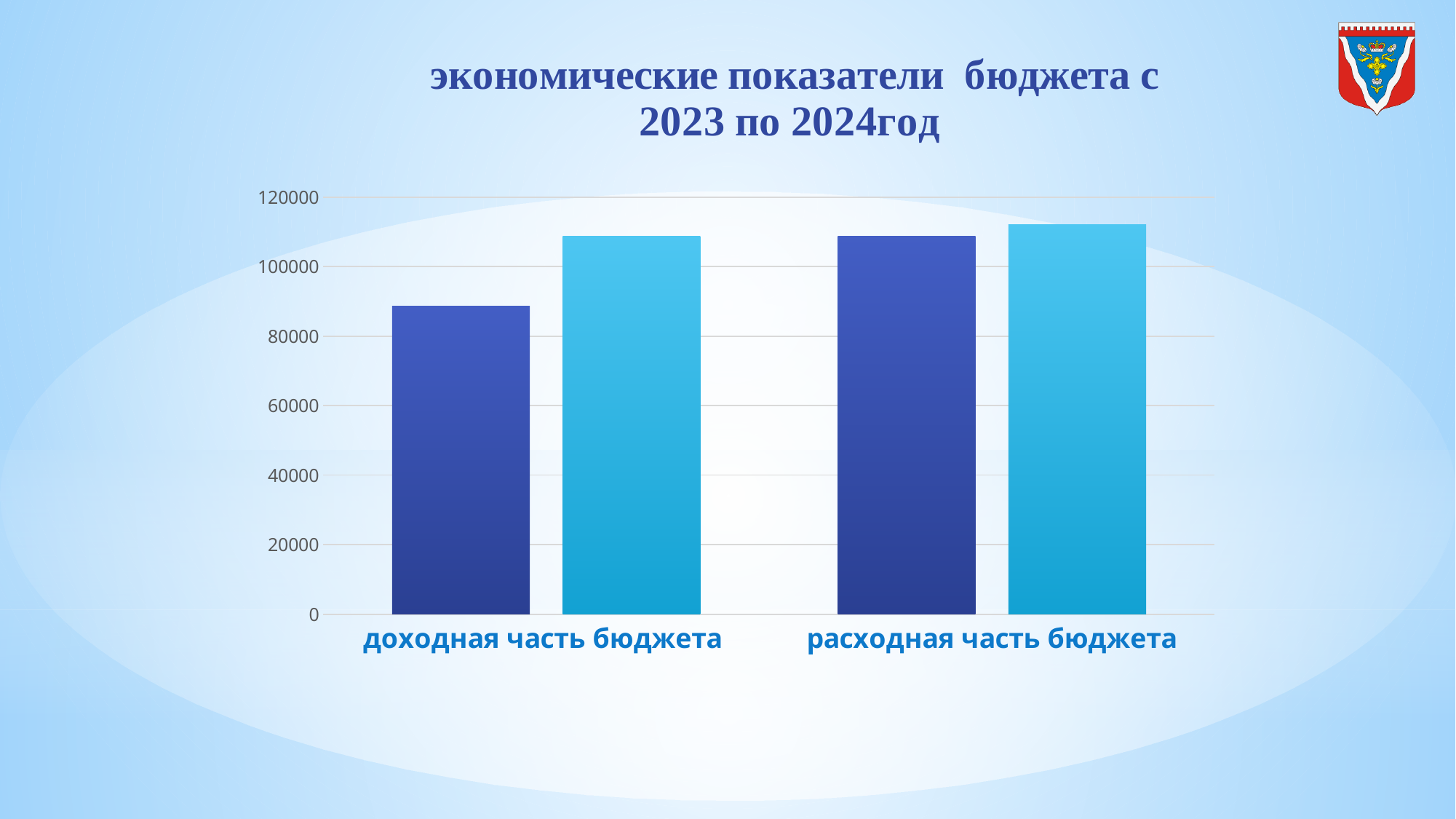
Is the dark blue bar for доходная часть бюджета greater or less than 100000? less Is the light blue bar for расходная часть бюджета greater or less than 120000? less Is the dark blue bar for доходная часть бюджета greater or less than 80000? greater What is the title of the chart on the slide? экономические показатели бюджета с 2023 по 2024год How many categories are shown on the x axis of the chart? 2 What kind of chart is shown on the slide? bar chart Which category has the shortest bar in the chart? доходная часть бюджета For доходная часть бюджета, which bar is taller, the dark blue one or the light blue one? the light blue one Which category has the taller dark blue bar, доходная часть бюджета or расходная часть бюджета? расходная часть бюджета What are the two category labels on the x axis? доходная часть бюджета, расходная часть бюджета